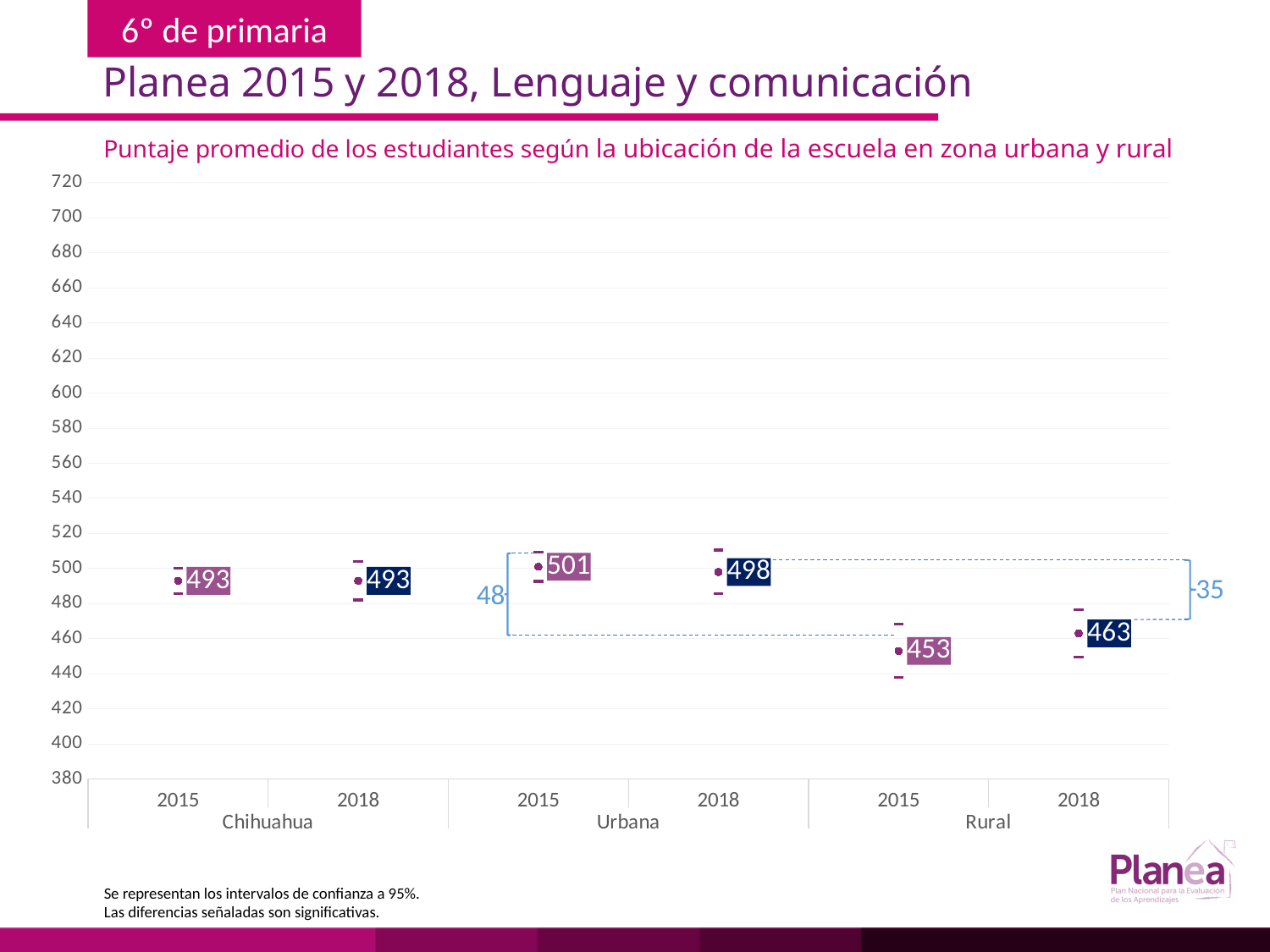
What is the average score for Urbana in 2015? 501 What is the average score for Urbana in 2018? 498 What is the average score for Rural in 2018? 463 How many data points are plotted on the chart? 6 Is the Rural 2015 score greater or less than 460? less Which is larger, the Rural score in 2015 or the Rural score in 2018? Rural 2018 Which group and year has the lowest average score? Rural 2015 What is the subtitle of the chart? Puntaje promedio de los estudiantes según la ubicación de la escuela en zona urbana y rural What is the average score for Chihuahua in 2015? 493 Which group and year has the highest average score? Urbana 2015 What is the difference between the Urbana 2018 score and the Rural 2018 score? 35 What is the difference between the Urbana 2015 score and the Rural 2015 score? 48